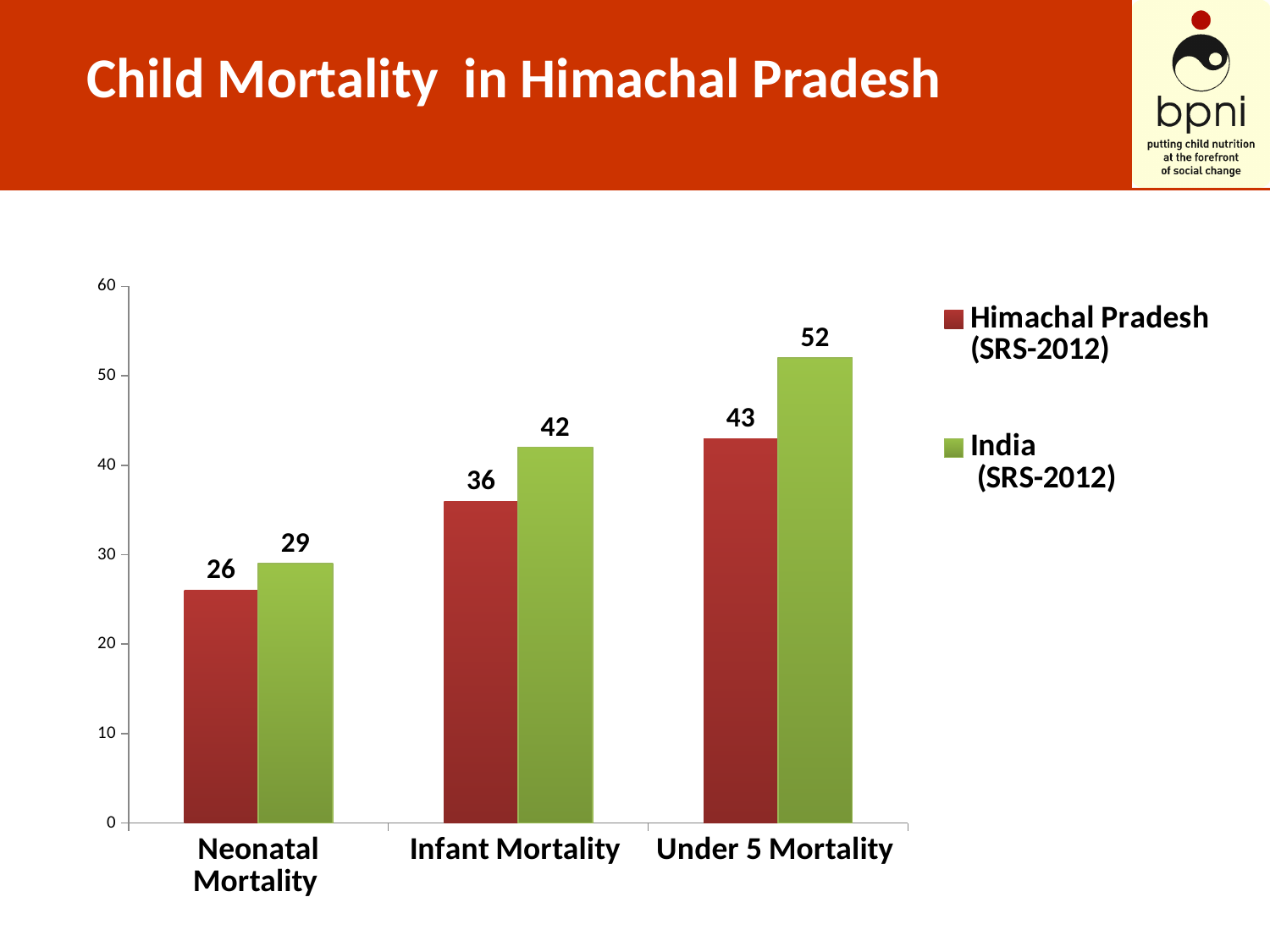
For Neonatal Mortality, which series has the larger value, Himachal Pradesh or India? India What is the Under 5 Mortality value for India (SRS-2012)? 52 Which category has the highest value for India (SRS-2012)? Under 5 Mortality What is the difference between the India and Himachal Pradesh values for Infant Mortality? 6 What is the difference between the India and Himachal Pradesh values for Under 5 Mortality? 9 Do the Himachal Pradesh values rise or fall from Neonatal Mortality to Under 5 Mortality? Rise What is the Infant Mortality value for Himachal Pradesh (SRS-2012)? 36 Which category has the lowest value for Himachal Pradesh (SRS-2012)? Neonatal Mortality What kind of chart is shown on the slide? Bar chart How many categories are shown on the x axis? 3 What is the Neonatal Mortality value for Himachal Pradesh (SRS-2012)? 26 How many series does the legend list? 2